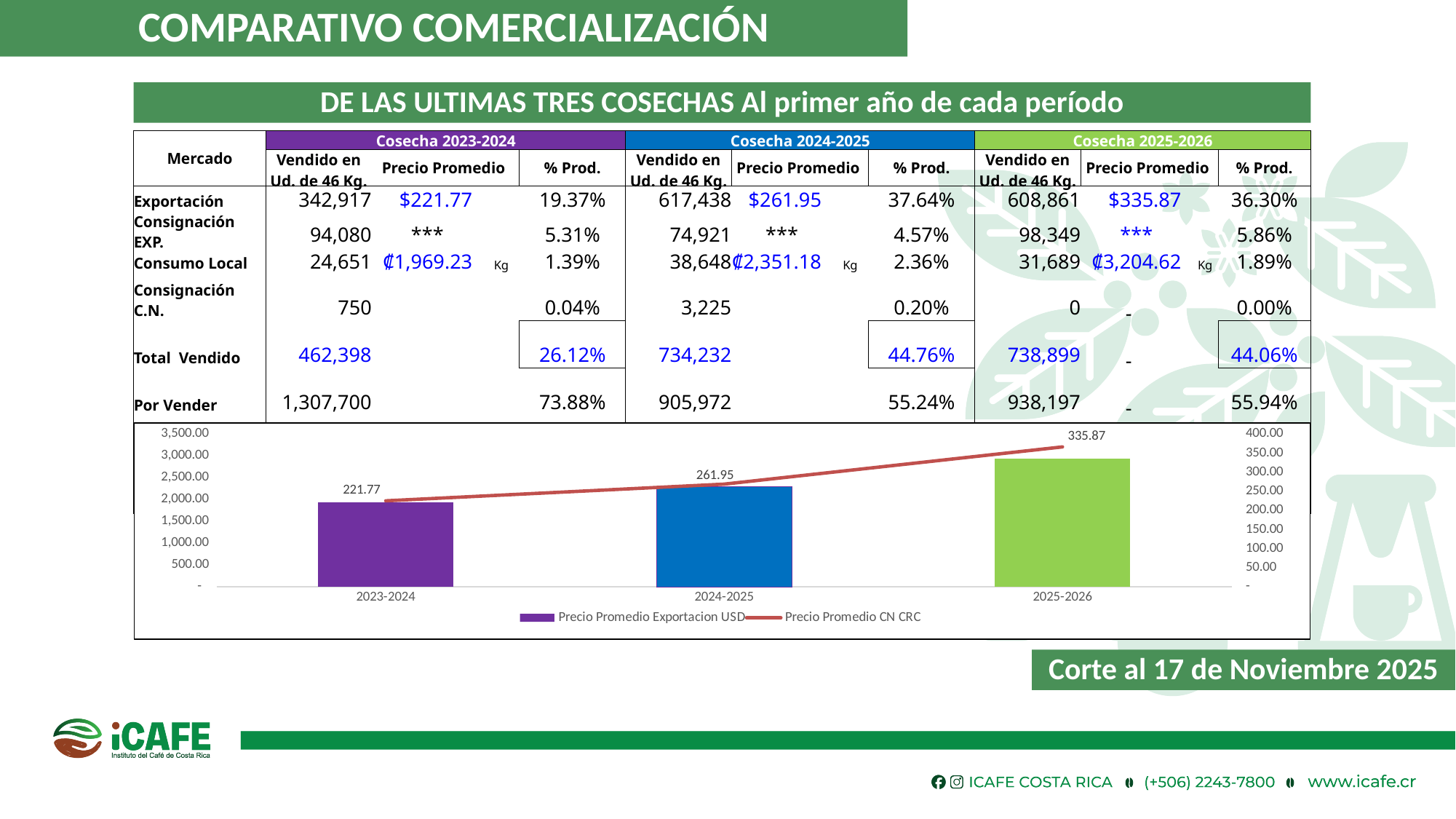
In the chart, which harvest period has the highest Precio Promedio Exportacion USD? 2025-2026 In the chart, what is the difference between the Precio Promedio Exportacion USD for 2025-2026 and 2023-2024? 114.10 In the chart, what is the Precio Promedio Exportacion USD value for 2025-2026? 335.87 How many harvest periods are shown on the x axis of the chart? 3 What type of chart is shown at the bottom of the slide? Bar chart with a line In the chart, which harvest period has the lowest Precio Promedio Exportacion USD? 2023-2024 In the chart, what is the Precio Promedio Exportacion USD value for 2023-2024? 221.77 In the chart, is the Precio Promedio CN CRC value for 2023-2024 greater or less than 2,500.00 on the left axis? less In the chart, which is larger: the Precio Promedio Exportacion USD for 2024-2025 or for 2023-2024? 2024-2025 How many series does the chart legend list? 2 In the chart, is the Precio Promedio CN CRC value for 2025-2026 greater or less than 2,500.00 on the left axis? greater In the chart, what is the Precio Promedio Exportacion USD value for 2024-2025? 261.95